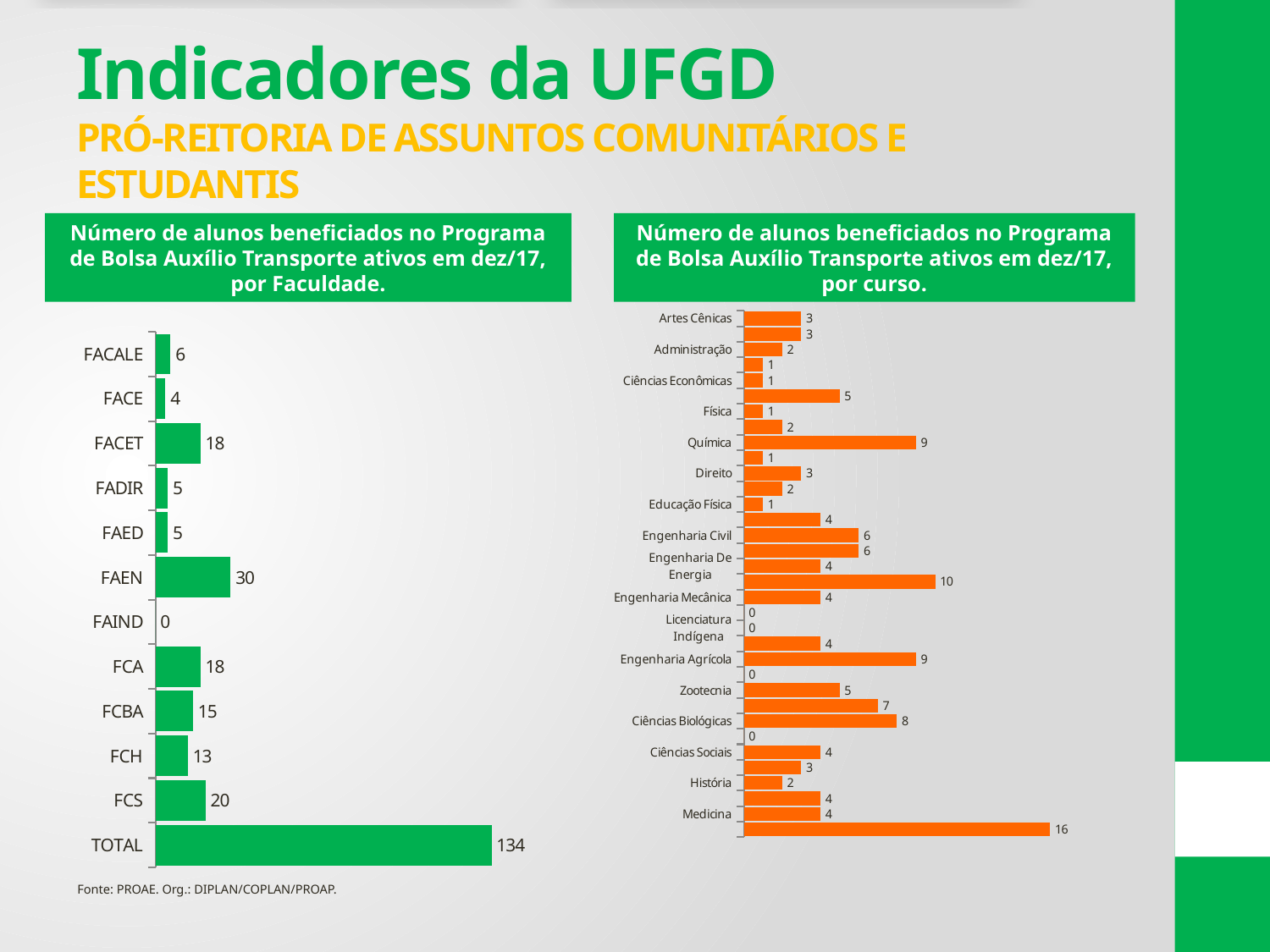
In the chart 'por Faculdade' on the left, what is the difference between the values for FACET and FCBA? 3 In the chart 'por Faculdade' on the left, what is the value for FCS? 20 What colour are the bars in the chart 'por curso' on the right? Orange In the chart 'por Faculdade' on the left, what is the value shown for TOTAL? 134 In the chart 'por Faculdade' on the left, which is larger, the value for FCH or the value for FCBA? FCBA What kind of chart is the chart 'por Faculdade' on the left? Bar chart In the chart 'por Faculdade' on the left, which faculty has the lowest value? FAIND In the chart 'por Faculdade' on the left, how many bars are plotted, including TOTAL? 12 In the chart 'por Faculdade' on the left, excluding the TOTAL bar, which faculty has the highest value? FAEN In the chart 'por Faculdade' on the left, what is the value for FAEN? 30 In the chart 'por Faculdade' on the left, what is the value for FACALE? 6 In the chart 'por curso' on the right, what is the highest value shown on any bar? 16